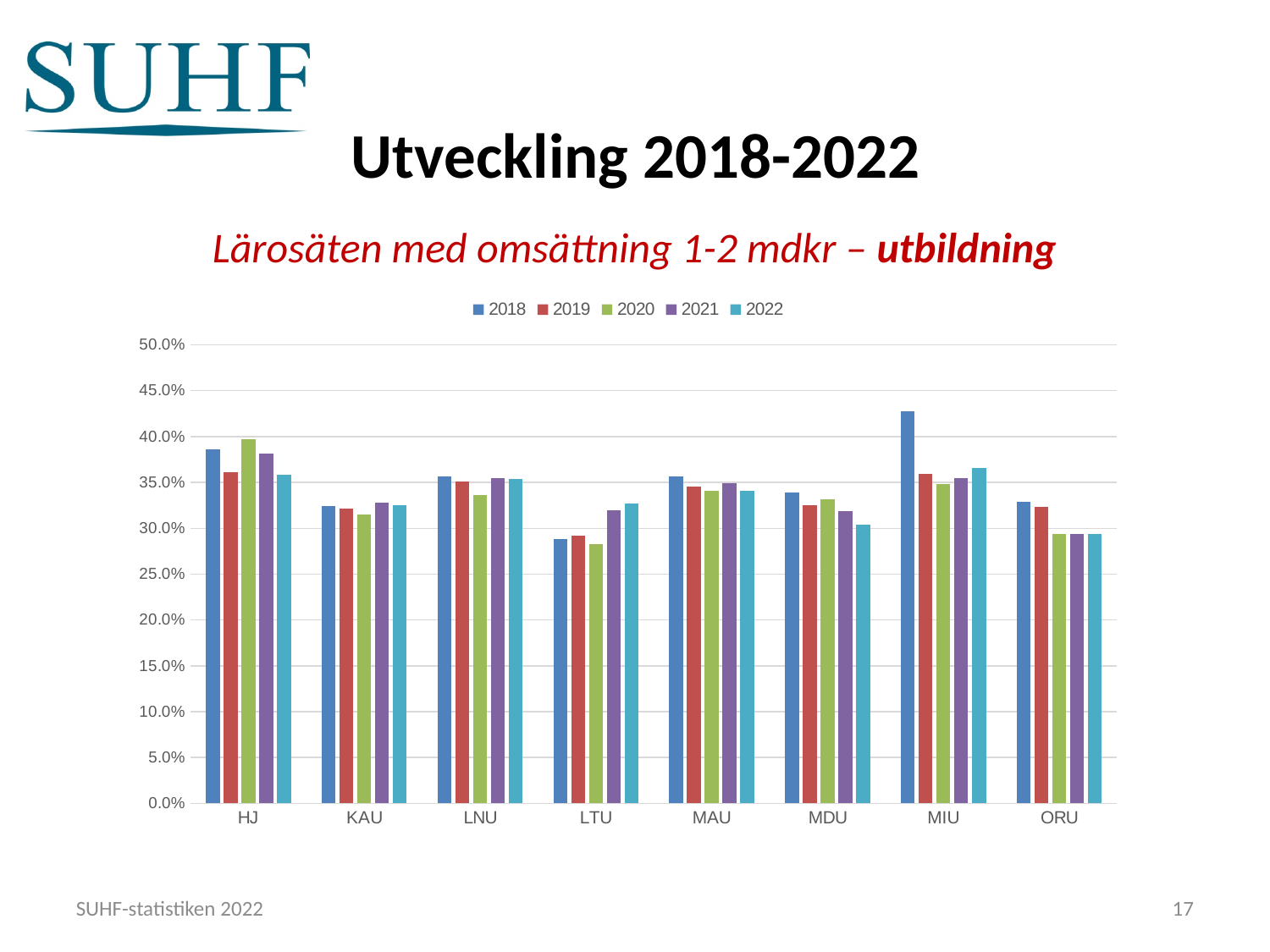
For ORU, is the 2022 value higher or lower than the 2018 value? lower How many series does the legend list? 5 Which year is represented by the blue bars according to the legend? 2018 Is the value for LTU in 2018 greater or less than 30.0%? less Is the value for HJ in 2020 greater or less than 35.0%? greater How many institutions (categories) are shown on the x axis? 8 Which institution has the lowest value for 2018? LTU Which institution has the highest value for 2018? MIU Which is larger, the 2018 value for HJ or the 2018 value for KAU? HJ What kind of chart is shown on the slide? bar chart Is the value for MIU in 2018 greater or less than 40.0%? greater